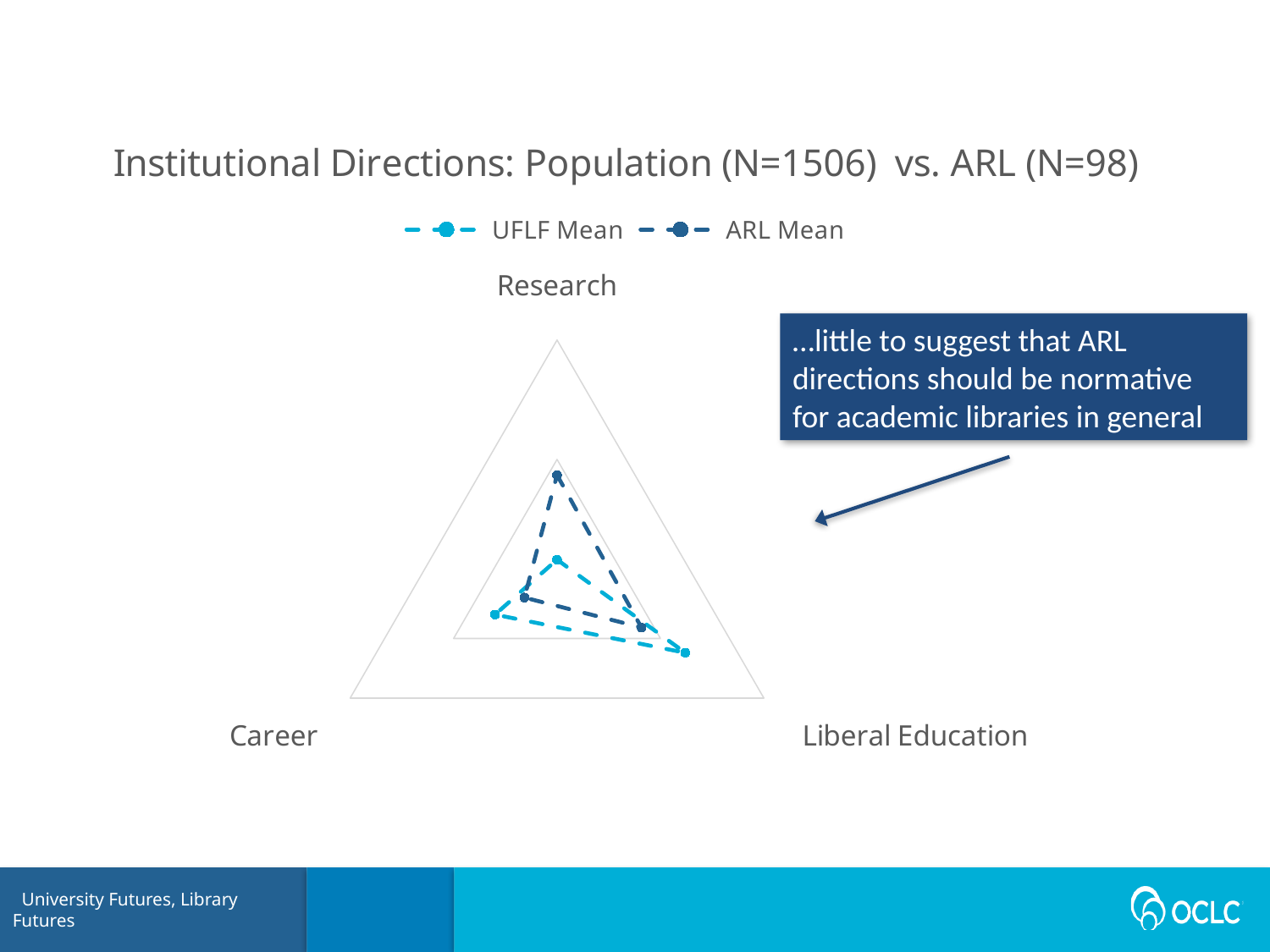
What kind of chart is shown on the slide? Radar chart On which axis does the UFLF Mean series reach its highest value? Liberal Education Which series has the higher value on the Research axis, UFLF Mean or ARL Mean? ARL Mean What are the two series named in the legend? UFLF Mean and ARL Mean What is the title of the chart? Institutional Directions: Population (N=1506) vs. ARL (N=98) How many axes (categories) does the radar chart have? 3 How many series does the legend list? 2 Which series has the higher value on the Career axis, UFLF Mean or ARL Mean? UFLF Mean On which axis does the ARL Mean series have its lowest value? Career Which series has the higher value on the Liberal Education axis, UFLF Mean or ARL Mean? UFLF Mean On which axis does the UFLF Mean series have its lowest value? Research